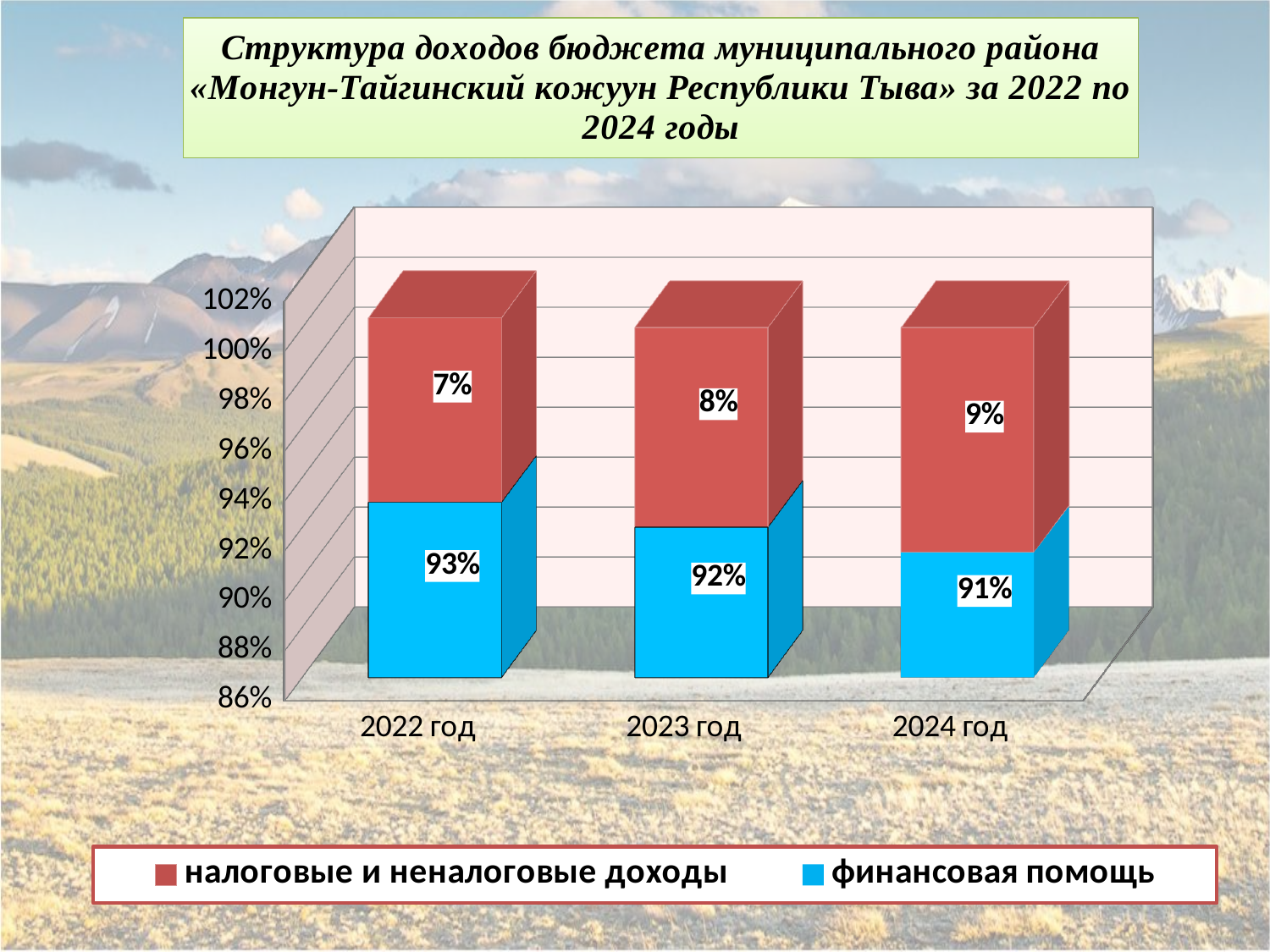
На сколько процентных пунктов доля финансовой помощи в 2022 году больше, чем в 2024 году? 2% Сколько лет (категорий) показано на диаграмме? 3 Сколько серий указано в легенде диаграммы? 2 Каким цветом на диаграмме обозначена серия «финансовая помощь»? Синим (голубым) Какого типа эта диаграмма? Столбчатая диаграмма с накоплением (bar chart) Какое значение имеет серия «налоговые и неналоговые доходы» за 2024 год? 9% В каком году доля налоговых и неналоговых доходов наибольшая? 2024 год Что больше: доля налоговых и неналоговых доходов в 2023 году или в 2022 году? 2023 год В каком году доля финансовой помощи наименьшая? 2024 год Какое значение имеет серия «финансовая помощь» за 2023 год? 92% Как меняется доля налоговых и неналоговых доходов с 2022 по 2024 год? Растёт Какое значение имеет серия «финансовая помощь» за 2022 год? 93%